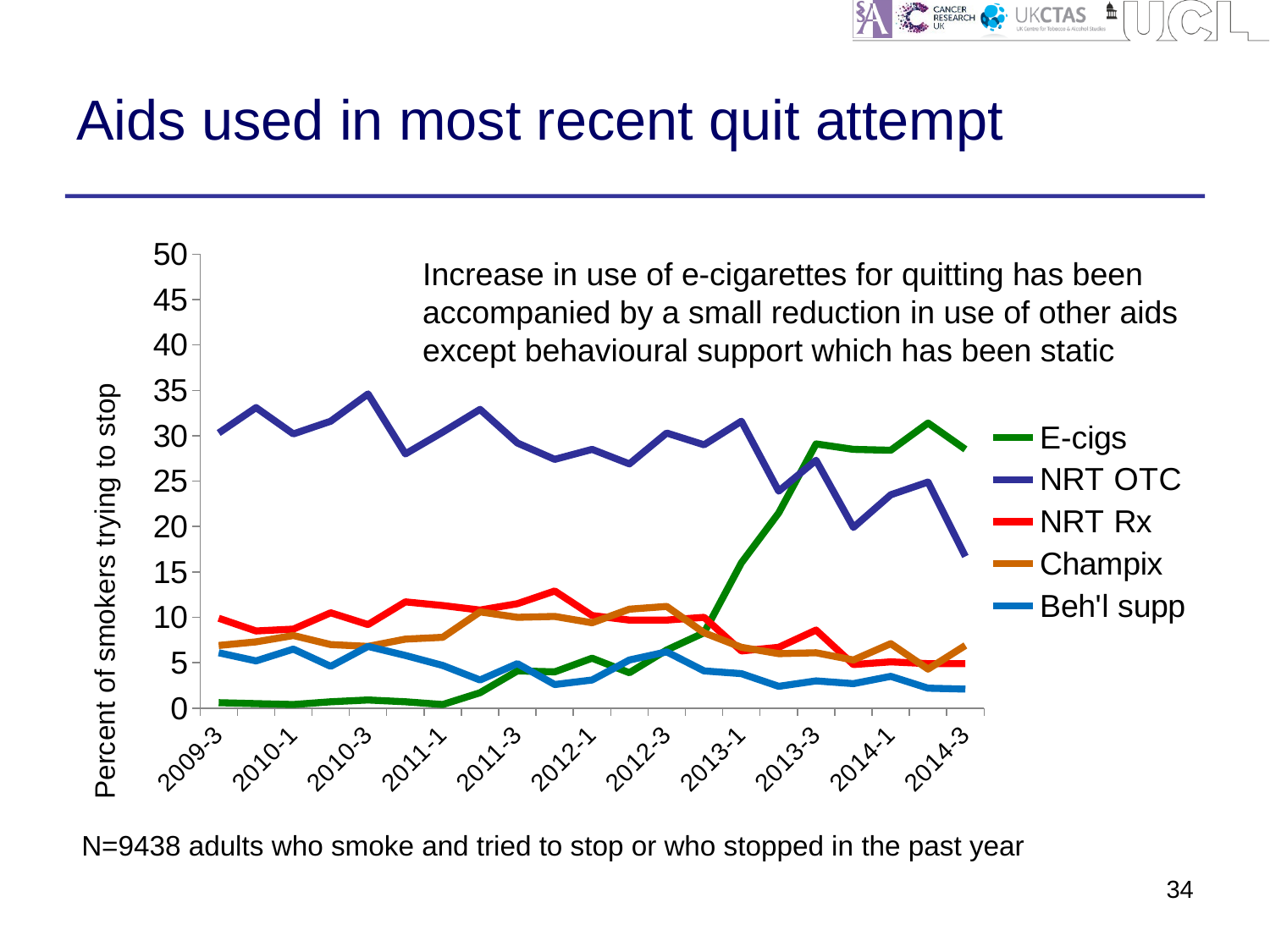
How many series does the legend list? 5 Is the value for E-cigs at 2011-1 greater or less than 5? less Is the value for E-cigs at 2014-3 greater or less than 20? greater What is the title of the slide's chart? Aids used in most recent quit attempt Which series has the highest value at 2009-3? NRT OTC What kind of chart is shown on the slide? line chart What is the label on the vertical axis? Percent of smokers trying to stop Which series has the highest value at 2014-3? E-cigs Is the value for NRT OTC at 2014-3 greater or less than 20? less At 2014-3, which is larger: the value for E-cigs or the value for NRT OTC? E-cigs Does the E-cigs line rise or fall overall from 2009-3 to 2014-3? rise